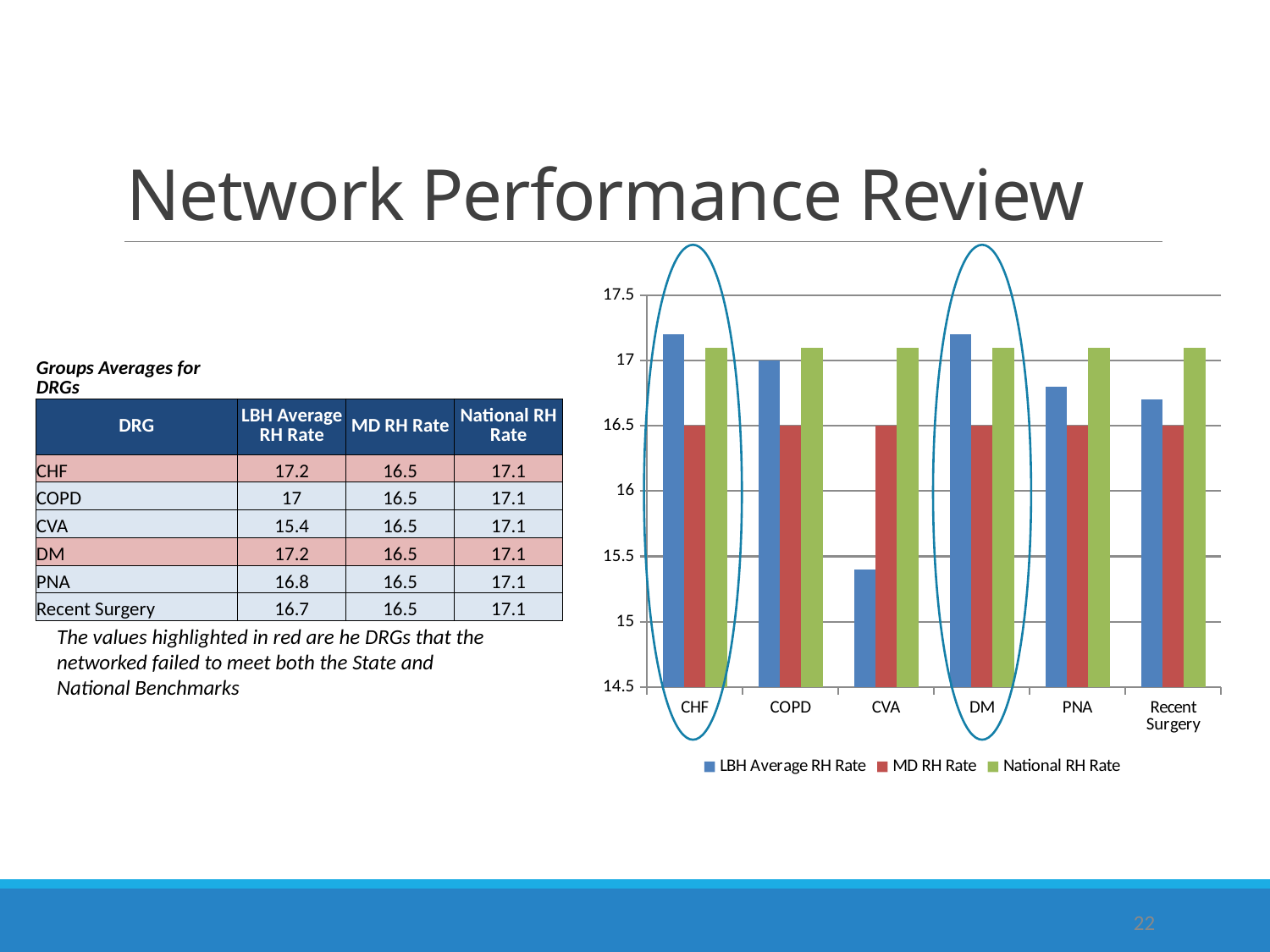
Which colour represents the National RH Rate series in the chart? green Which is larger for PNA, the LBH Average RH Rate or the National RH Rate? National RH Rate What is the MD RH Rate for COPD? 16.5 What kind of chart is shown on the slide? bar chart How many series does the chart legend list? 3 What is the difference between the LBH Average RH Rate and the MD RH Rate for DM? 0.7 Is the LBH Average RH Rate for CVA greater or less than 16? less How many DRG categories are shown on the x axis of the chart? 6 What is the LBH Average RH Rate for COPD? 17 Which DRG has the lowest LBH Average RH Rate? CVA Is the LBH Average RH Rate for CHF greater or less than 17? greater What is the LBH Average RH Rate for CVA? 15.4